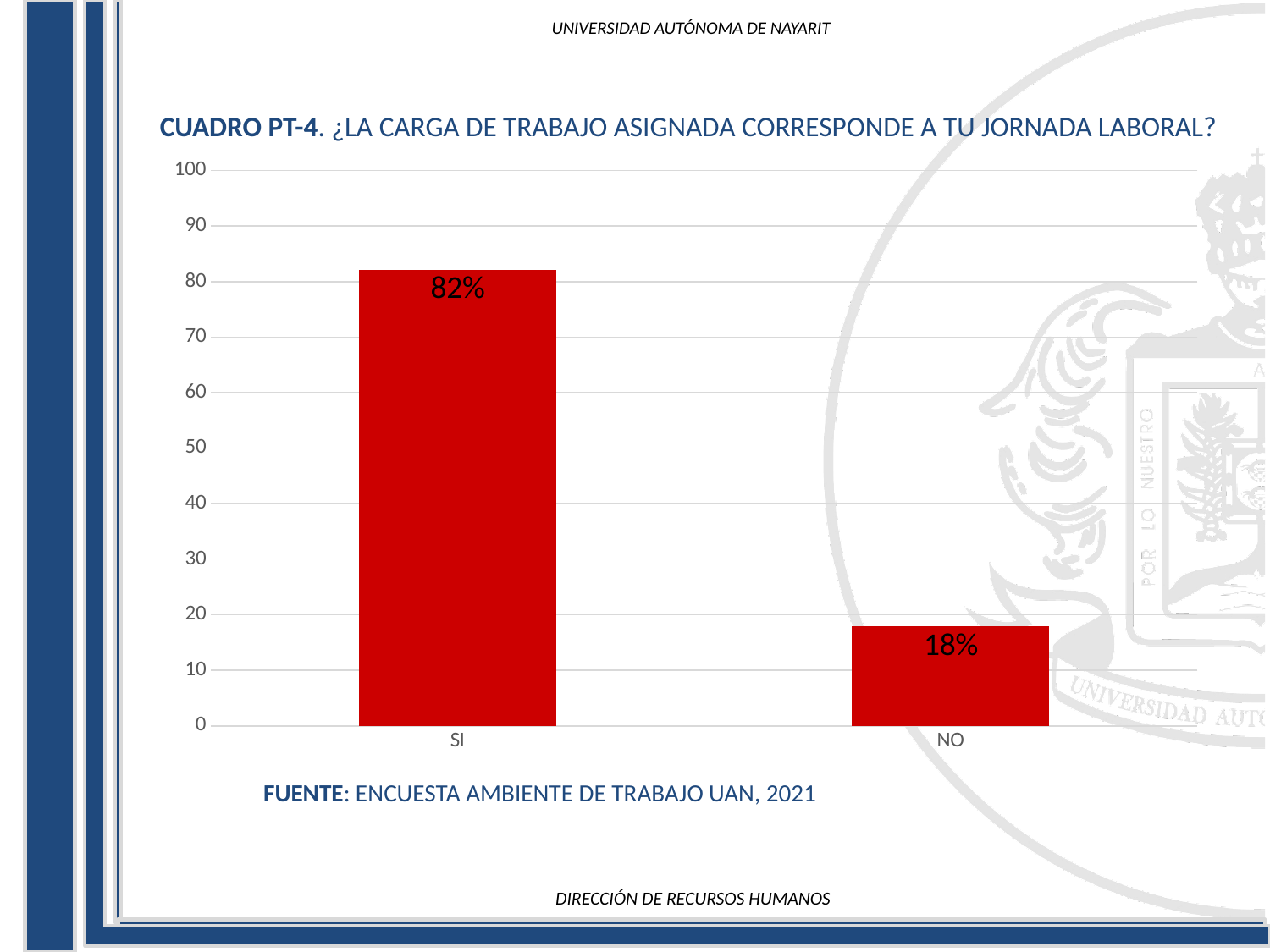
What kind of chart is shown on the slide? bar chart What is the title of the chart? CUADRO PT-4. ¿LA CARGA DE TRABAJO ASIGNADA CORRESPONDE A TU JORNADA LABORAL? What is the value for NO? 18% Is the value for NO greater or less than 20? less What is the value for SI? 82% Which is larger, the value for SI or the value for NO? SI What is the difference between the values for SI and NO? 64% Is the value for SI greater or less than 80? greater What colour are the bars in the chart? red Which category has the lowest value? NO How many categories are shown on the x axis? 2 Which category has the highest value? SI